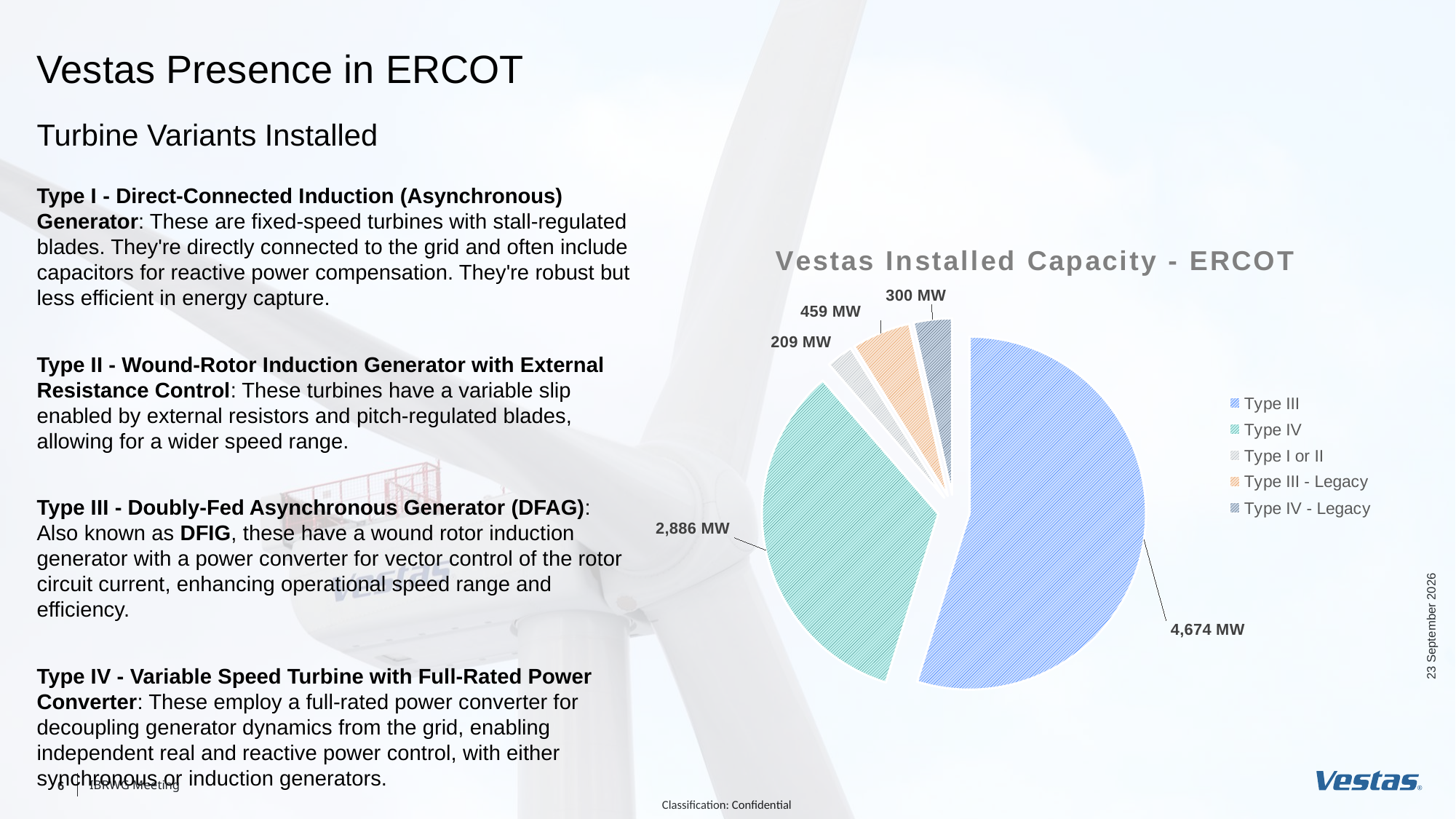
What is the installed capacity for Type IV? 2,886 MW What is the installed capacity for Type I or II? 209 MW What is the title of the chart? Vestas Installed Capacity - ERCOT What is the installed capacity for Type III - Legacy? 459 MW What type of chart is shown on the slide? Pie chart Which has a larger installed capacity, Type III - Legacy or Type IV - Legacy? Type III - Legacy What is the difference in installed capacity between Type III and Type IV? 1,788 MW What is the installed capacity for Type III? 4,674 MW Which category has the largest installed capacity? Type III What is the installed capacity for Type IV - Legacy? 300 MW Which category has the smallest installed capacity? Type I or II How many categories does the legend of the pie chart list? 5